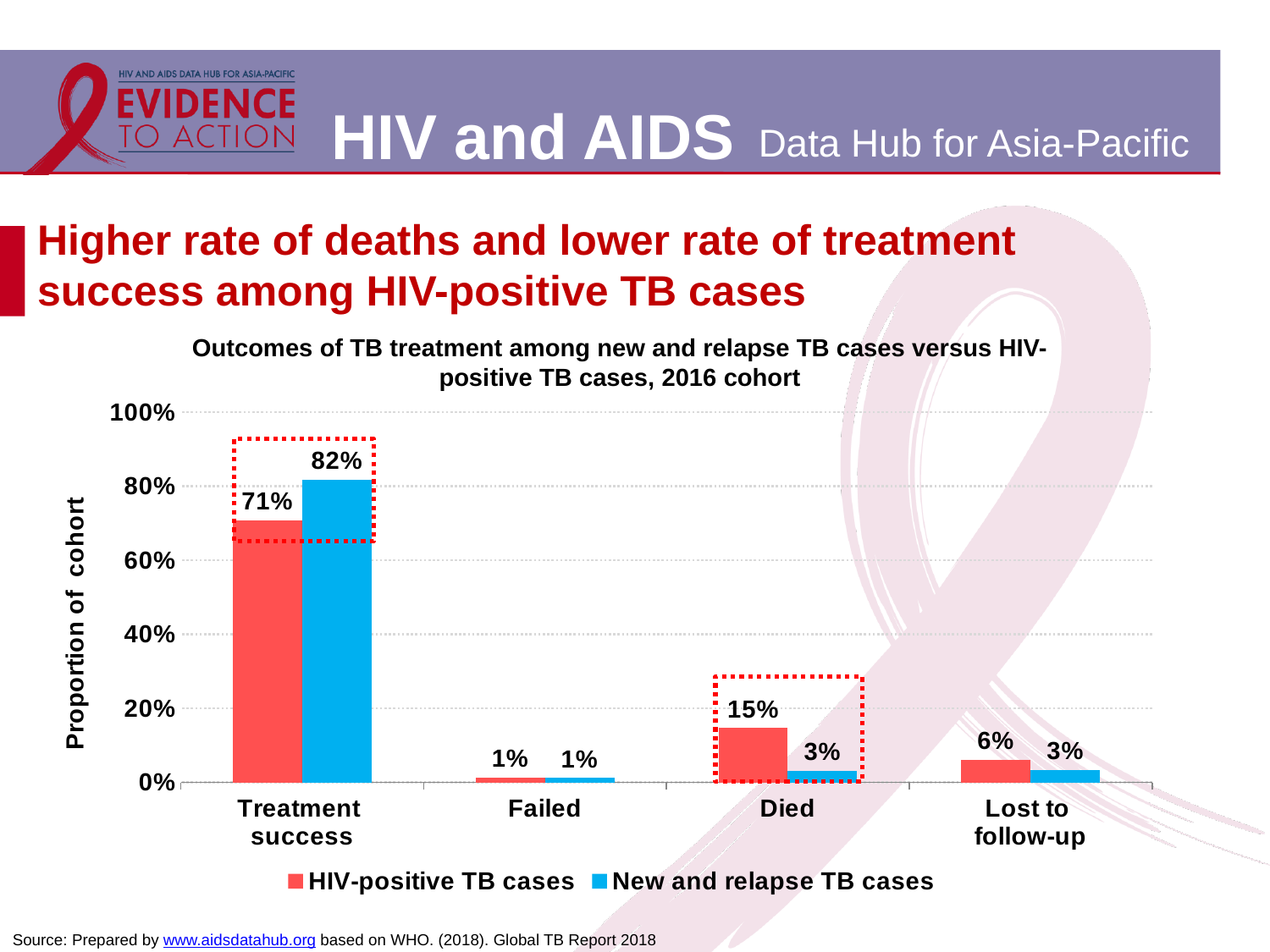
What is the treatment success rate for HIV-positive TB cases? 71% Which outcome category has the lowest value for new and relapse TB cases? Failed What proportion of HIV-positive TB cases died? 15% What type of chart is shown on the slide? Bar chart What is the difference in treatment success between new and relapse TB cases and HIV-positive TB cases? 11% How many series does the legend list? 2 Which group has a higher proportion lost to follow-up, HIV-positive TB cases or new and relapse TB cases? HIV-positive TB cases What is the treatment success rate for new and relapse TB cases? 82% What proportion of new and relapse TB cases were lost to follow-up? 3% Which outcome category has the highest value for HIV-positive TB cases? Treatment success What is the difference in the proportion who died between HIV-positive TB cases and new and relapse TB cases? 12% How many outcome categories are shown on the x axis? 4